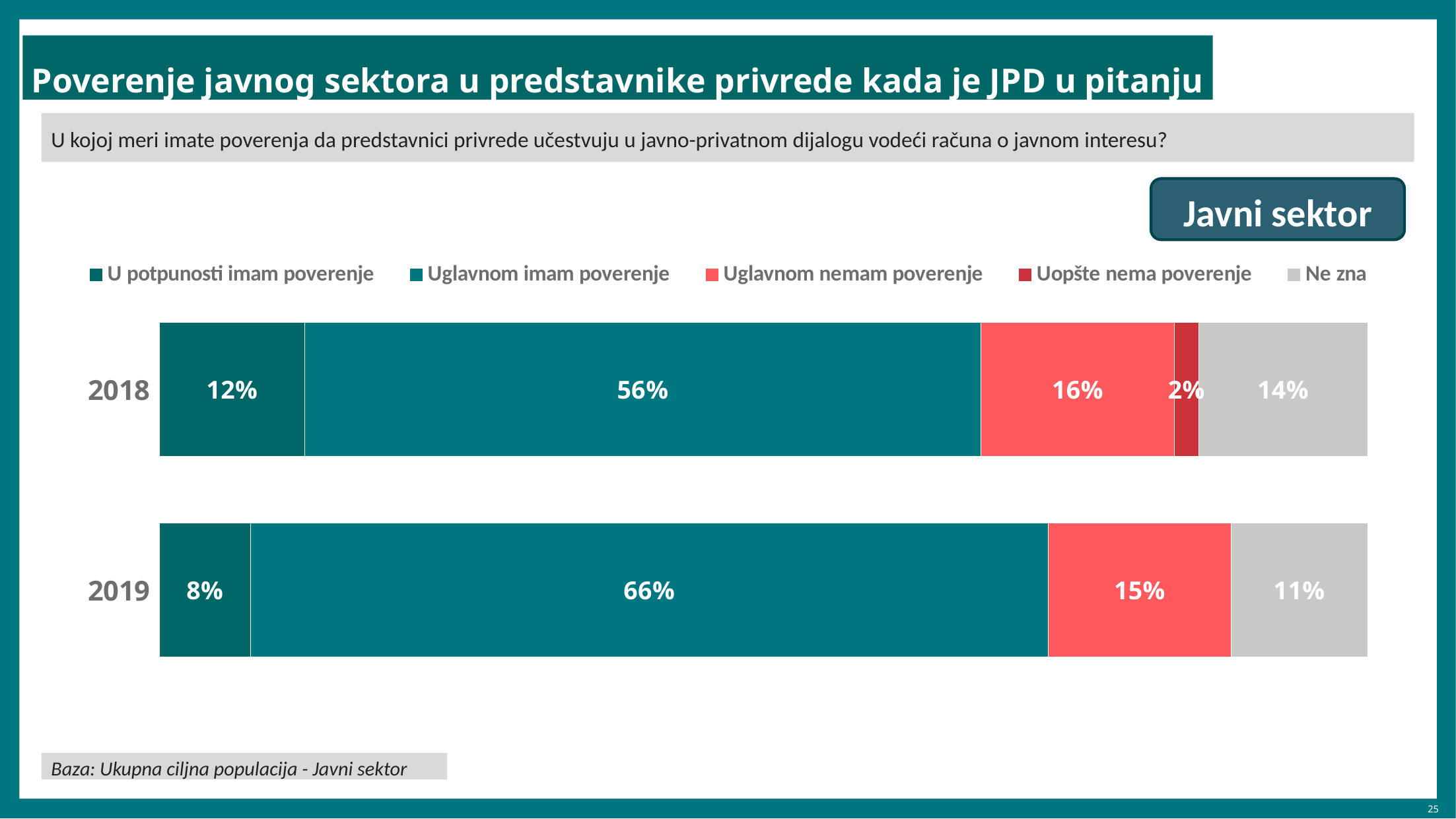
What kind of chart is shown on the slide? stacked bar chart What is the value for "U potpunosti imam poverenje" in 2019? 8% Which series has the smallest share in 2018? Uopšte nema poverenje What is the difference between the "Uglavnom imam poverenje" values for 2019 and 2018? 10 percentage points What is the value for "Ne zna" in 2018? 14% What is the value for "Uopšte nema poverenje" in 2018? 2% How many series does the legend list? 5 What is the value for "Uglavnom imam poverenje" in 2018? 56% Which year has the larger value for "Uglavnom nemam poverenje", 2018 or 2019? 2018 Which series has the largest share in 2019? Uglavnom imam poverenje Does the "U potpunosti imam poverenje" value rise or fall from 2018 to 2019? fall How many years (categories) are plotted in the chart? 2